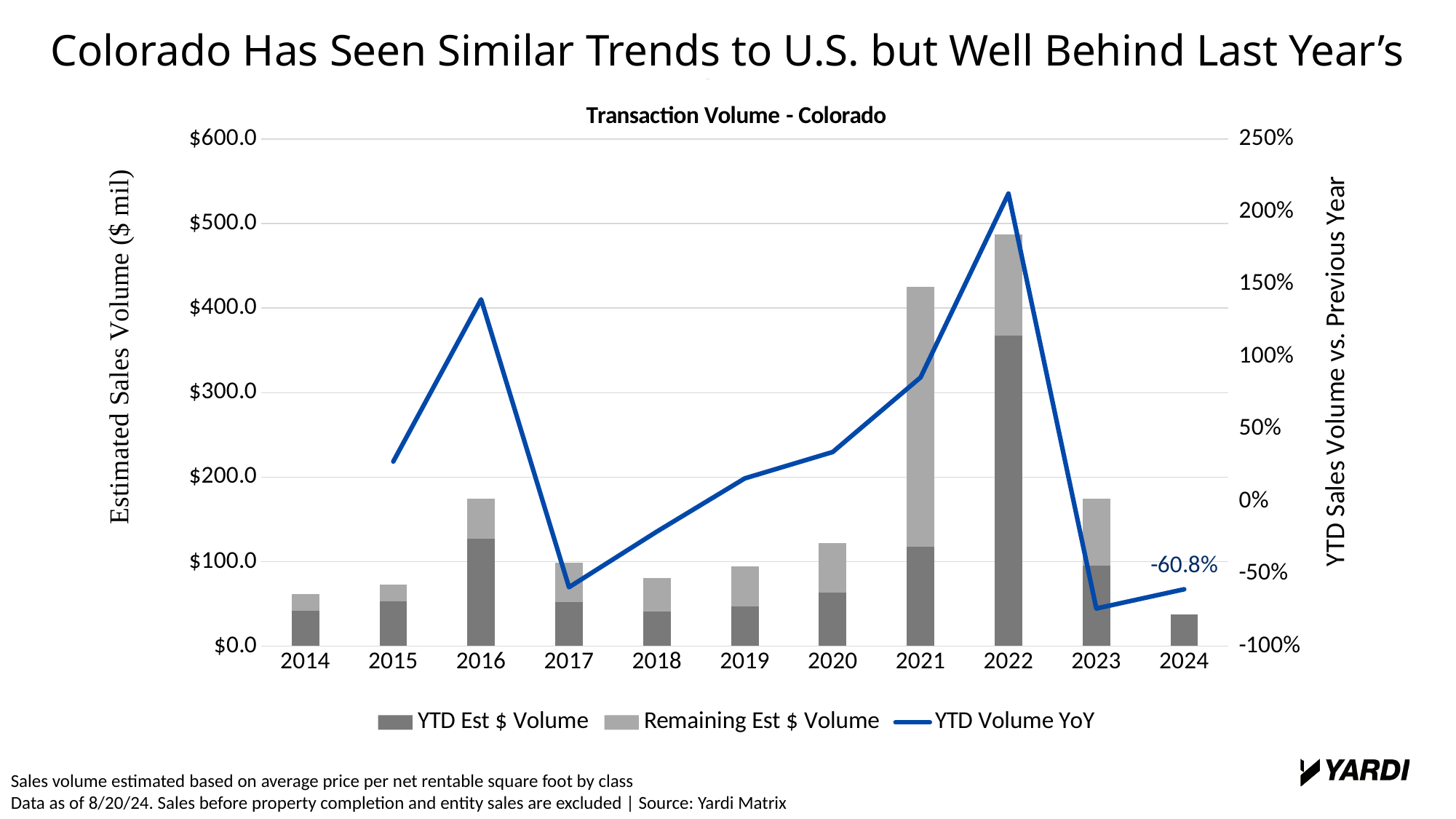
Which year has the tallest stacked bar for estimated sales volume? 2022 In which year does the YTD Volume YoY line reach its highest point? 2022 What is the title of the chart? Transaction Volume - Colorado Is the total estimated sales volume for 2022 greater or less than $400.0 million? greater Which year has the larger total estimated sales volume, 2021 or 2022? 2022 Does the YTD Volume YoY line rise or fall from 2022 to 2023? fall How many years are shown on the x axis? 11 Which year has the shortest stacked bar for estimated sales volume? 2024 How many series does the legend list? 3 What kind of chart is this? Stacked bar chart with a line Is the total estimated sales volume for 2016 greater or less than $200.0 million? less What is the YTD Volume YoY value labeled for 2024? -60.8%